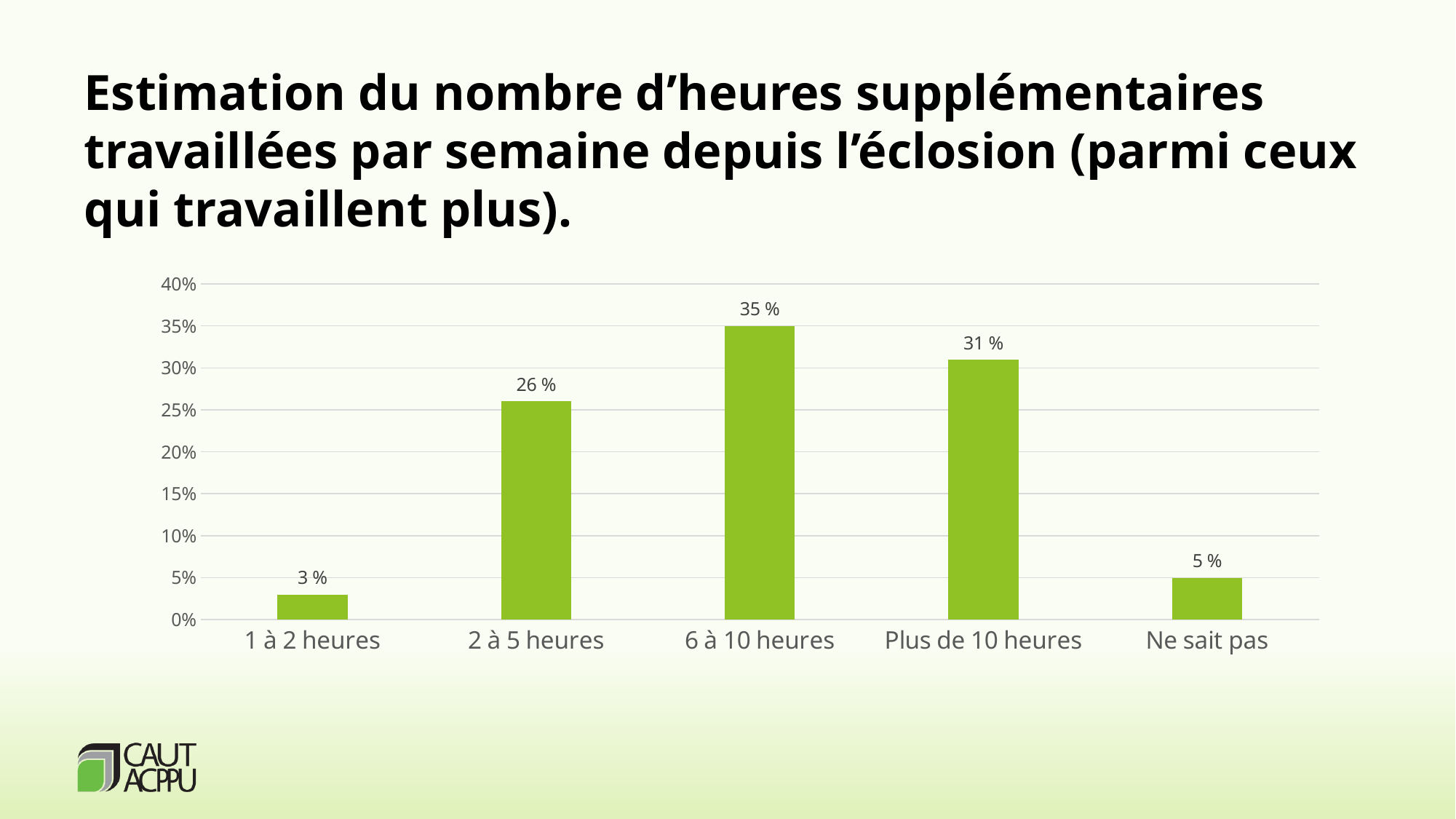
What kind of chart is shown on the slide? bar chart What is the value for "Ne sait pas"? 5 % What is the value for "6 à 10 heures"? 35 % Which category has the lowest value? 1 à 2 heures Which is larger, the value for "2 à 5 heures" or the value for "Plus de 10 heures"? Plus de 10 heures What is the difference between the values for "6 à 10 heures" and "Plus de 10 heures"? 4 % Is the value for "Plus de 10 heures" greater or less than 20%? greater What is the value for "1 à 2 heures"? 3 % How many categories are shown on the x axis? 5 Which category has the highest value? 6 à 10 heures What is the difference between the values for "2 à 5 heures" and "1 à 2 heures"? 23 % What is the highest value shown on the y axis? 40%